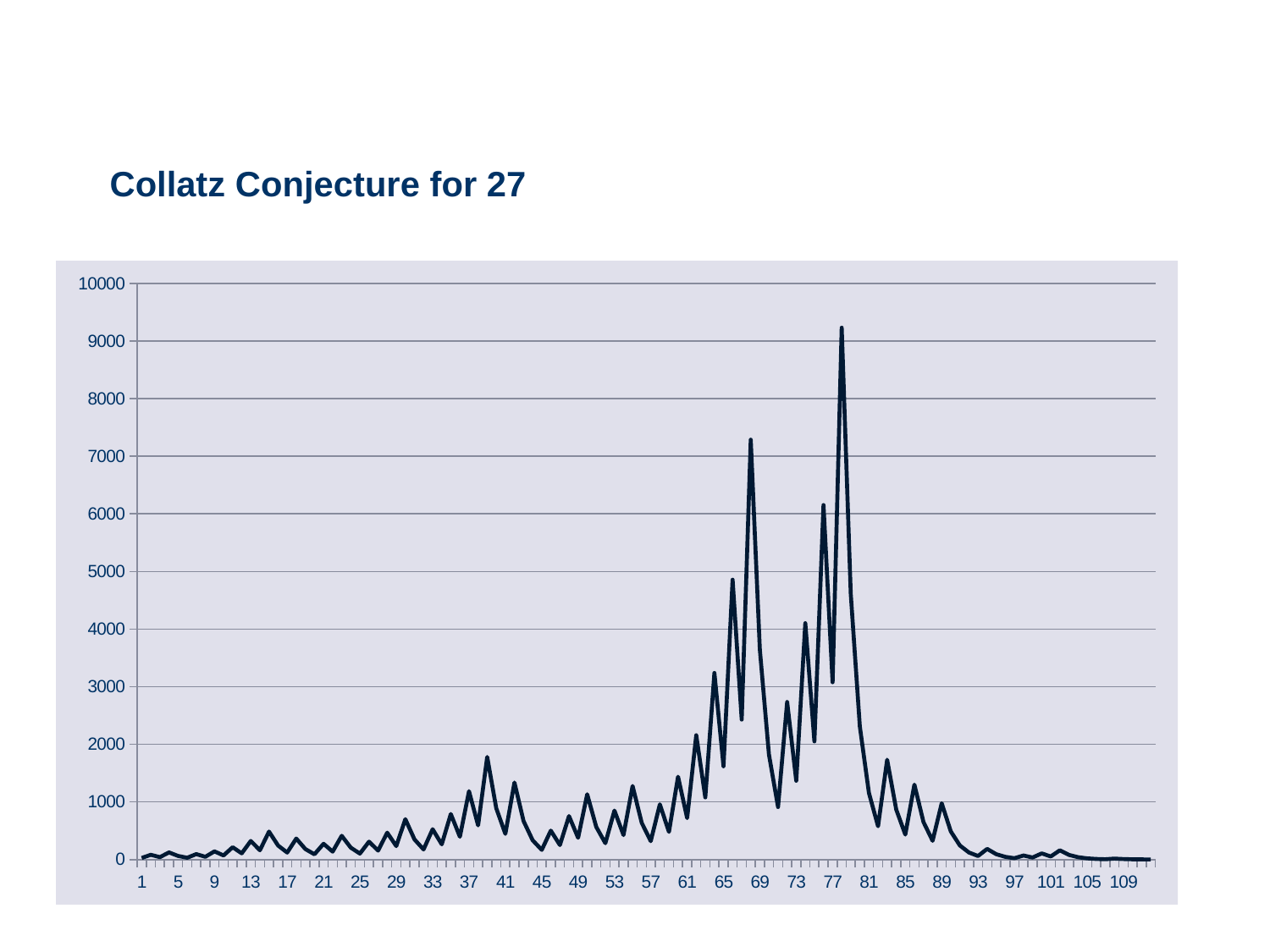
What kind of chart is shown on the slide? line chart Which is larger, the peak near x = 69 or the peak near x = 78? the peak near x = 78 What is the title of the chart? Collatz Conjecture for 27 What is the highest value labelled on the y axis? 10000 Is the highest point on the line greater or less than 9000? greater Is the value at x = 1 greater or less than 1000? less Is the highest point on the line greater or less than 10000? less Do the values rise or fall along the x axis after x = 89? fall